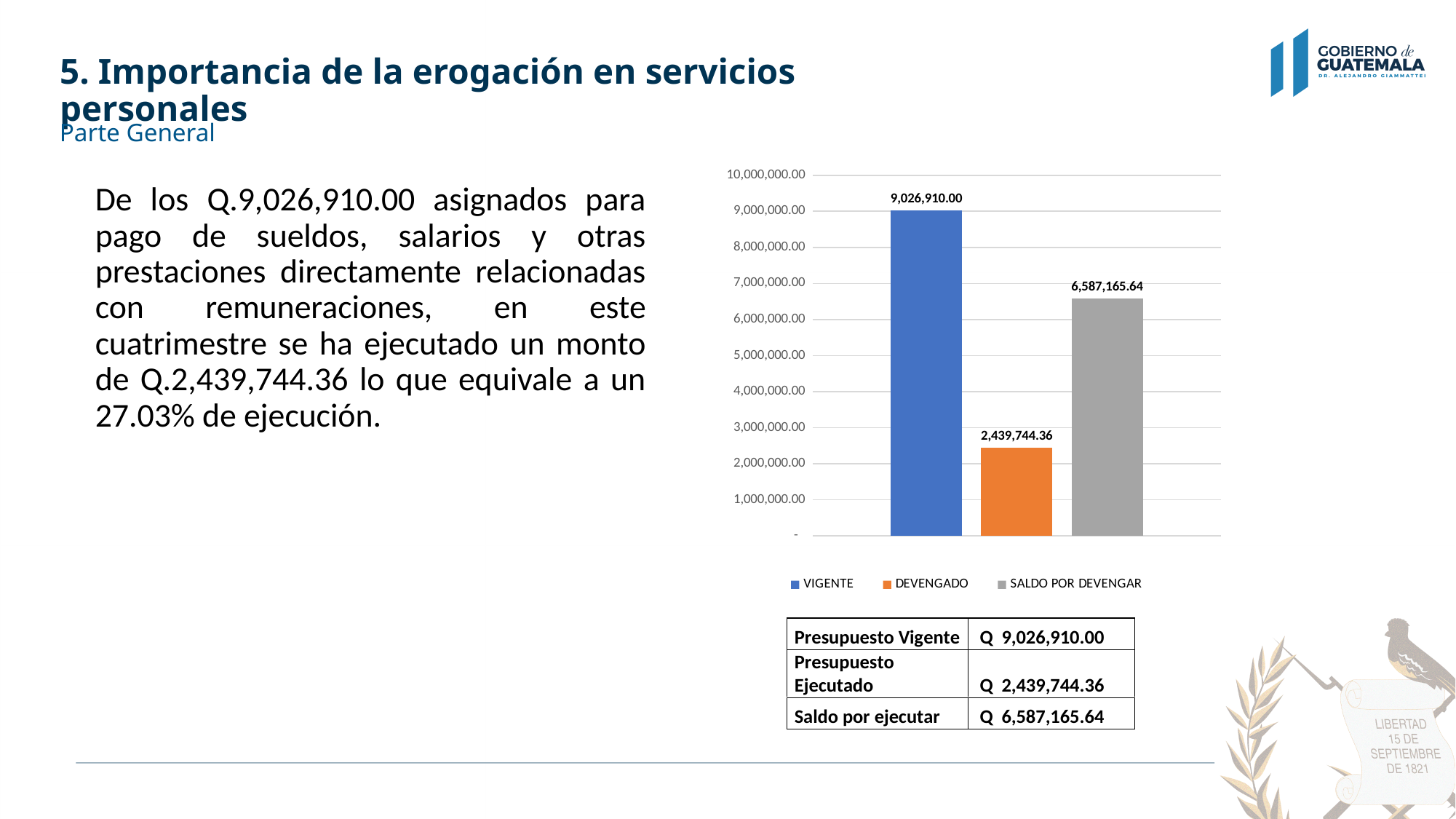
What is the value of the VIGENTE bar? 9,026,910.00 Which series has the lowest value? DEVENGADO What is the difference between the VIGENTE and DEVENGADO values? 6,587,165.64 What is the value of the SALDO POR DEVENGAR bar? 6,587,165.64 How many series does the legend list? 3 What is the value of the DEVENGADO bar? 2,439,744.36 What is the difference between the SALDO POR DEVENGAR and DEVENGADO values? 4,147,421.28 Which series has the highest value? VIGENTE Is the value for DEVENGADO greater or less than 3,000,000.00? less Which is larger, SALDO POR DEVENGAR or DEVENGADO? SALDO POR DEVENGAR What kind of chart is shown on the slide? bar chart What colour is the DEVENGADO bar? orange